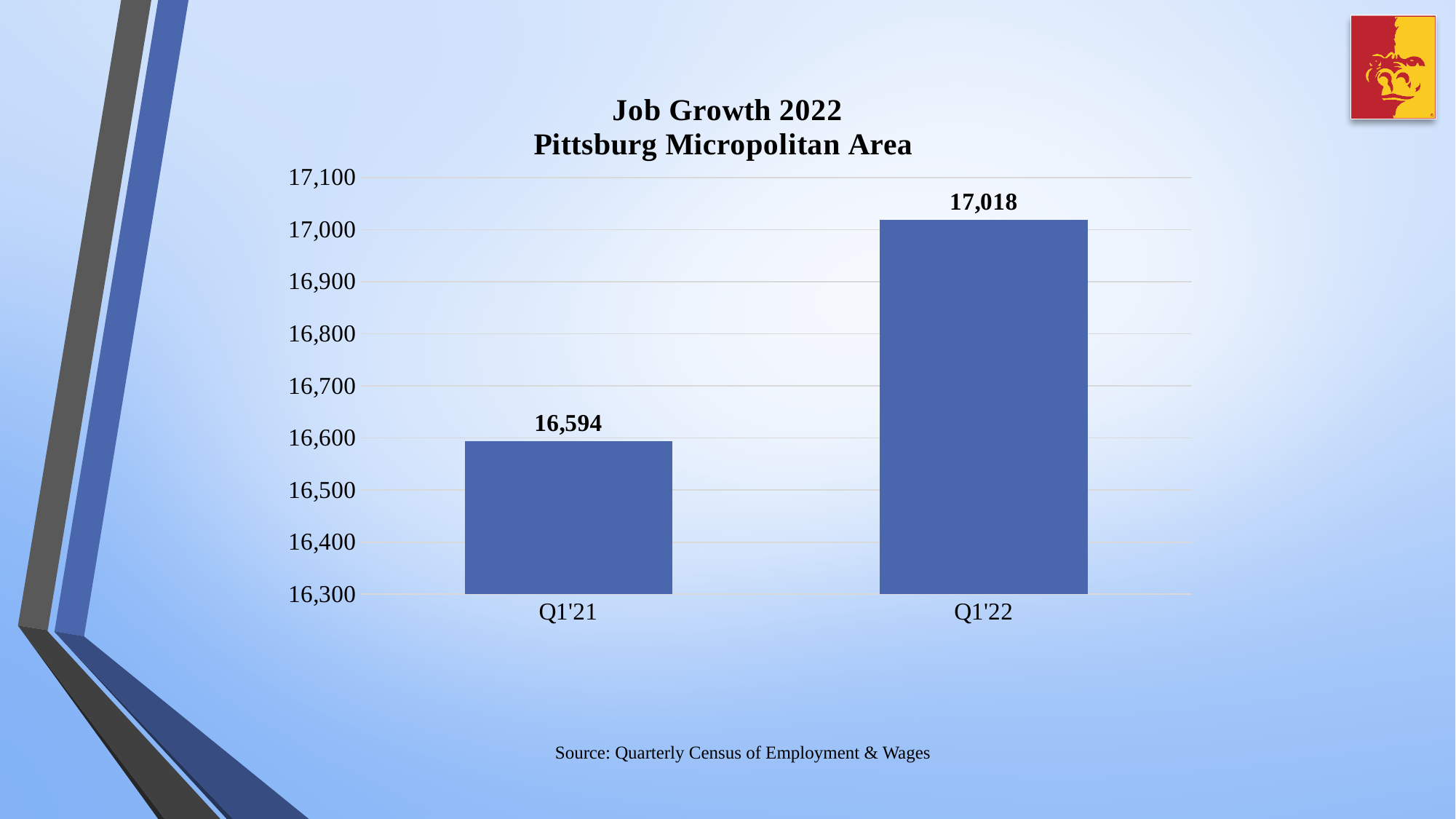
What is the title of the chart? Job Growth 2022 Pittsburg Micropolitan Area Which category has the highest value? Q1'22 Is the value for Q1'22 greater or less than 17,000? greater Which category has the lowest value? Q1'21 What is the difference between the values for Q1'22 and Q1'21? 424 Is the value for Q1'21 greater or less than 16,600? less How many categories are shown on the x axis? 2 What is the value for Q1'21? 16,594 What kind of chart is shown on the slide? bar chart What is the value for Q1'22? 17,018 Do the values rise or fall from Q1'21 to Q1'22? rise Which is larger, the value for Q1'21 or the value for Q1'22? Q1'22